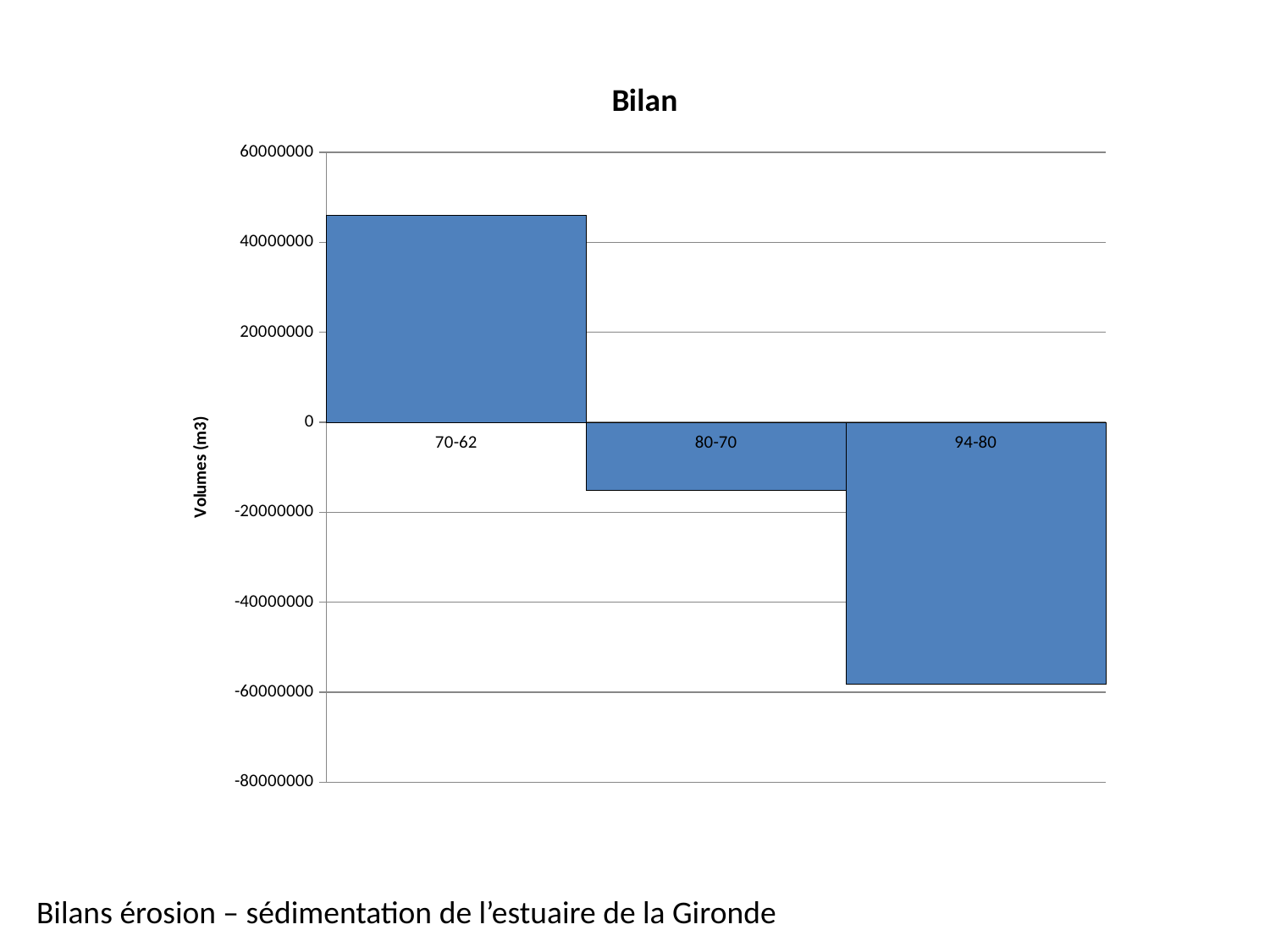
Which category has the lowest value? 94-80 Do the values rise or fall from left to right across the categories? fall Which category has the highest value? 70-62 Is the value for 80-70 greater or less than 0? less Is the value for 70-62 greater or less than 40000000? greater What is the label of the vertical axis? Volumes (m3) What is the title of the chart? Bilan Which has the larger value, 80-70 or 94-80? 80-70 How many categories are plotted on the chart? 3 Is the value for 80-70 greater or less than -20000000? greater What type of chart is shown on the slide? bar chart